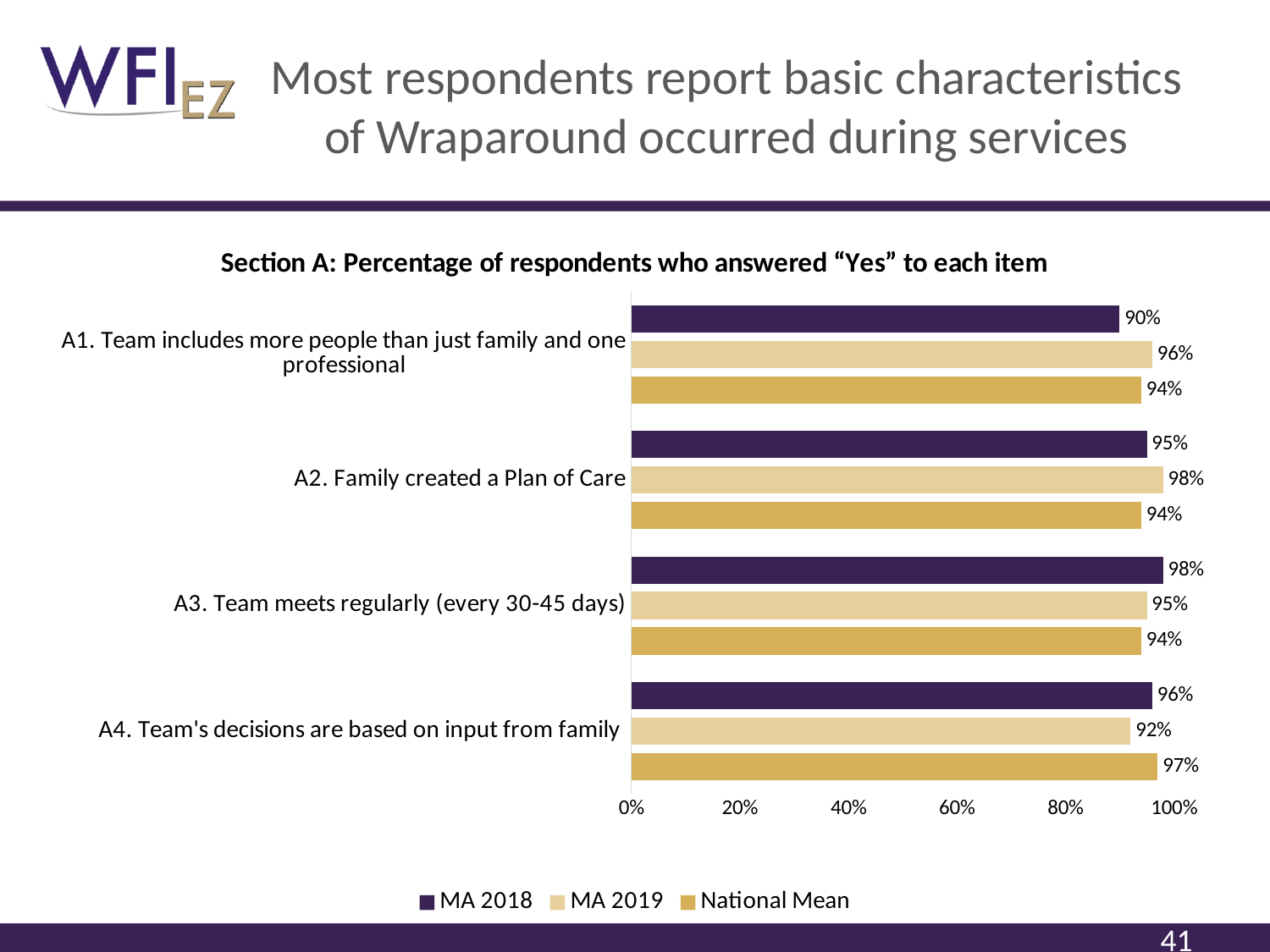
What is the MA 2018 value for A1. Team includes more people than just family and one professional? 90% How many items (categories) are shown on the chart? 4 What kind of chart is shown on the slide? Bar chart For A4. Team's decisions are based on input from family, which is larger: MA 2018 or MA 2019? MA 2018 What is the title of the chart? Section A: Percentage of respondents who answered "Yes" to each item What is the MA 2019 value for A2. Family created a Plan of Care? 98% Which item has the lowest MA 2019 value? A4. Team's decisions are based on input from family What is the National Mean value for A4. Team's decisions are based on input from family? 97% How many series does the legend list? 3 What is the difference between the MA 2019 and MA 2018 values for A1. Team includes more people than just family and one professional? 6% Which item has the highest MA 2018 value? A3. Team meets regularly (every 30-45 days) Which series is shown in dark purple in the legend? MA 2018